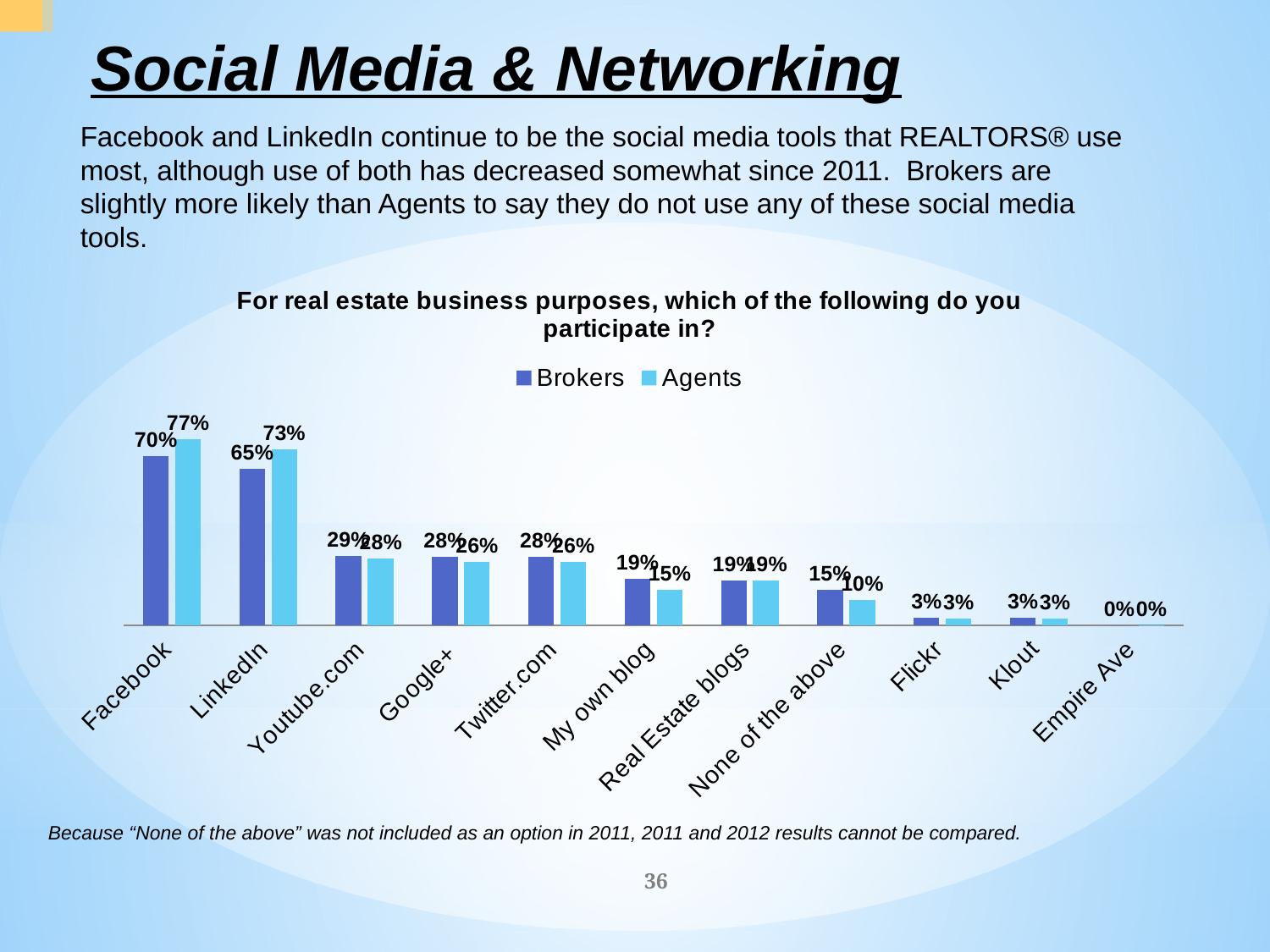
For 'None of the above', which is larger: the Brokers value or the Agents value? Brokers How many series does the legend list? 2 What is the difference between the Agents and Brokers values for Facebook? 7% Which category has the lowest value for Brokers? Empire Ave What percentage of Agents participate in LinkedIn? 73% What percentage of Brokers participate in Facebook? 70% Which category has the highest value for Agents? Facebook How many categories are shown on the x axis? 11 What is the value for Brokers for 'My own blog'? 19% What are the two series named in the legend? Brokers and Agents What kind of chart is shown on the slide? Bar chart What is the value for Agents for 'None of the above'? 10%